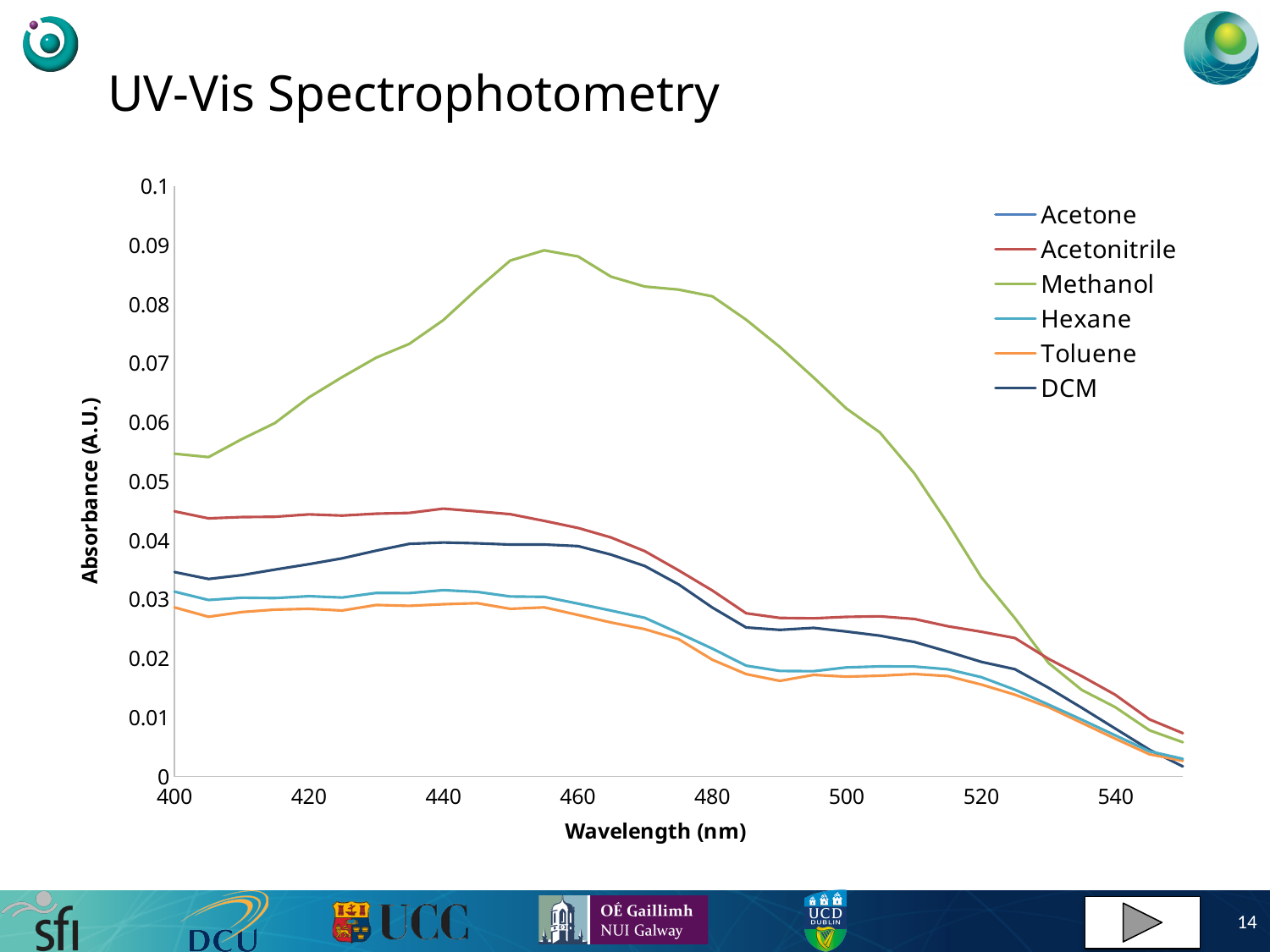
Which solvent has the lowest absorbance at 400 nm? Toluene Is the absorbance of Acetonitrile at 440 nm greater or less than 0.05? less What is the title of the x axis? Wavelength (nm) What is the title of the y axis? Absorbance (A.U.) What kind of chart is shown on the slide? line chart At 480 nm, which has the higher absorbance, Hexane or DCM? DCM Is the absorbance of DCM at 550 nm greater or less than 0.01? less Which solvent has the highest absorbance at 460 nm? Methanol Is the absorbance of Methanol at 460 nm greater or less than 0.08? greater Does the Methanol absorbance rise or fall between 400 nm and 455 nm? rise How many series does the legend list? 6 At 500 nm, which has the higher absorbance, Methanol or Acetonitrile? Methanol